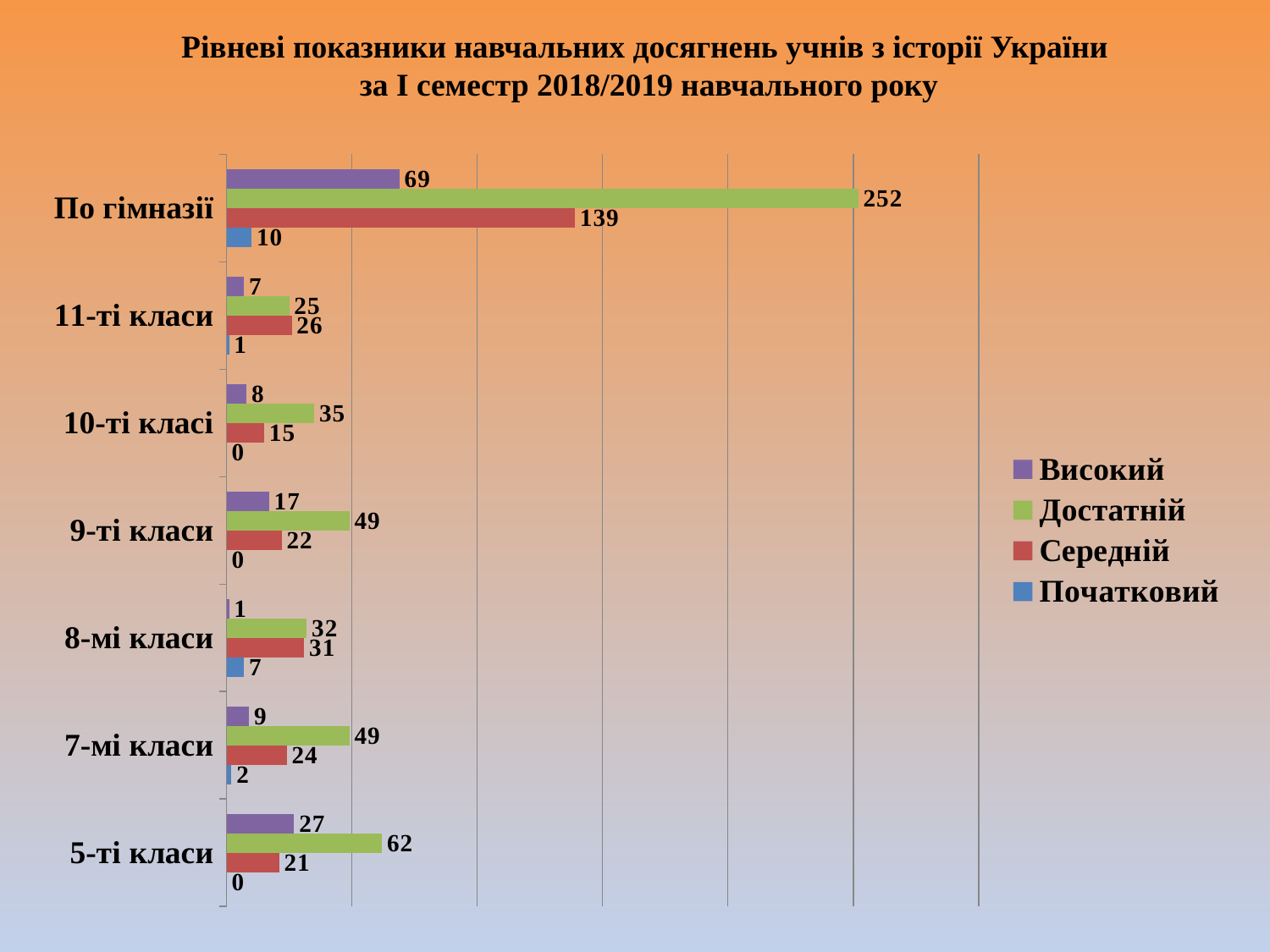
How many categories are shown on the chart? 7 Which colour represents the Початковий series in the legend? Blue How many series does the legend list? 4 What is the value of Достатній for По гімназії? 252 Which category has the highest Високий value? По гімназії Which is larger for 11-ті класи: Достатній or Середній? Середній What kind of chart is shown on the slide? Bar chart What is the value of Початковий for 7-мі класи? 2 Among the class categories (excluding По гімназії), which has the lowest Достатній value? 11-ті класи What is the difference between the Достатній and Середній values for По гімназії? 113 What is the value of Високий for 5-ті класи? 27 What is the value of Середній for 8-мі класи? 31